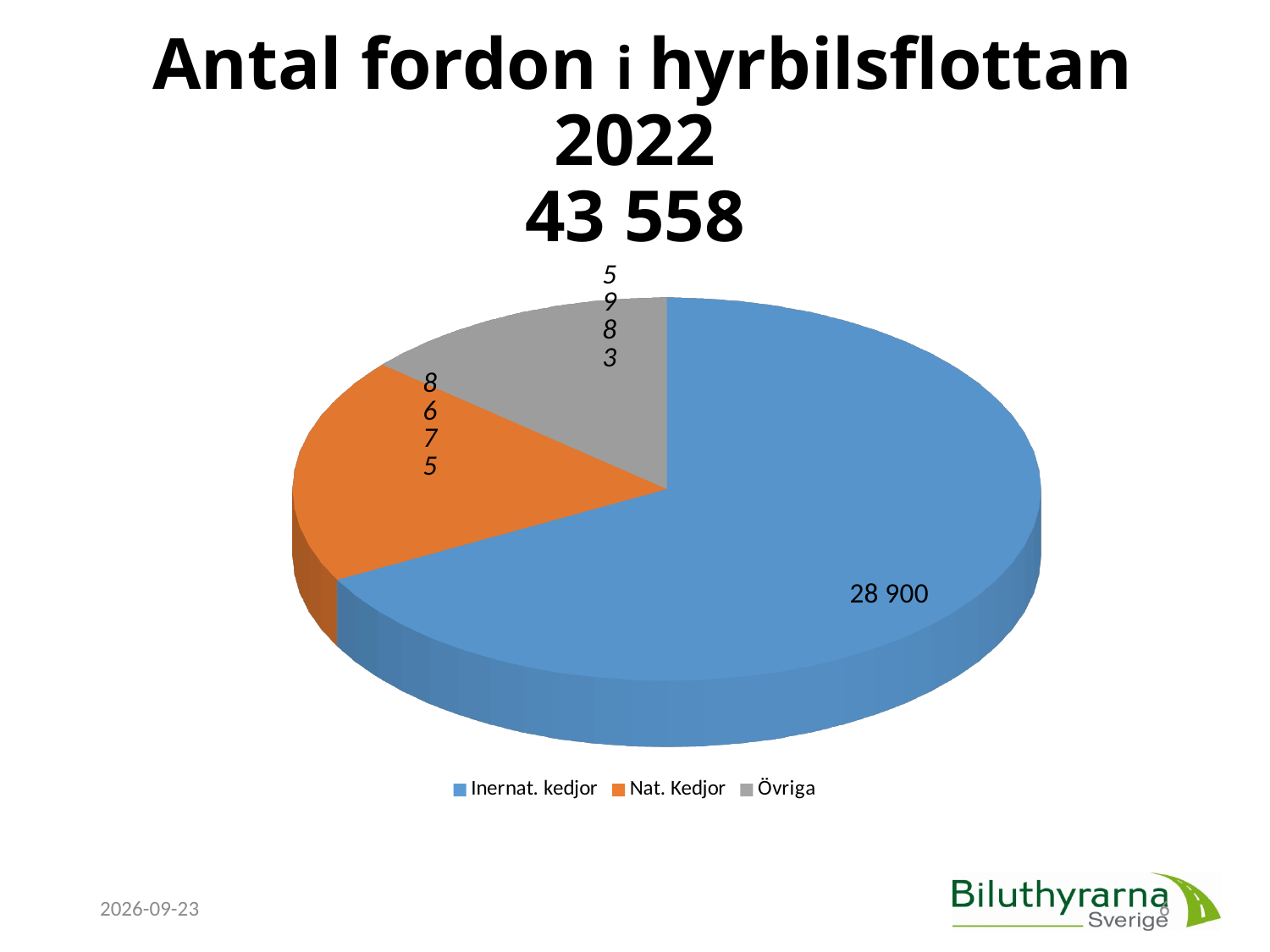
Which is larger, Nat. Kedjor or Övriga? Nat. Kedjor What colour is the Övriga slice? grey What total number of vehicles is given in the chart title? 43 558 What is the value for Övriga? 5 983 What kind of chart is shown on the slide? pie chart How many entries does the legend list? 3 What is the value for Nat. Kedjor? 8 675 Which category has the largest slice of the pie? Inernat. kedjor What is the difference between the values for Inernat. kedjor and Nat. Kedjor? 20 225 What is the value for Inernat. kedjor? 28 900 How many slices does the pie chart have? 3 Which category has the smallest slice of the pie? Övriga